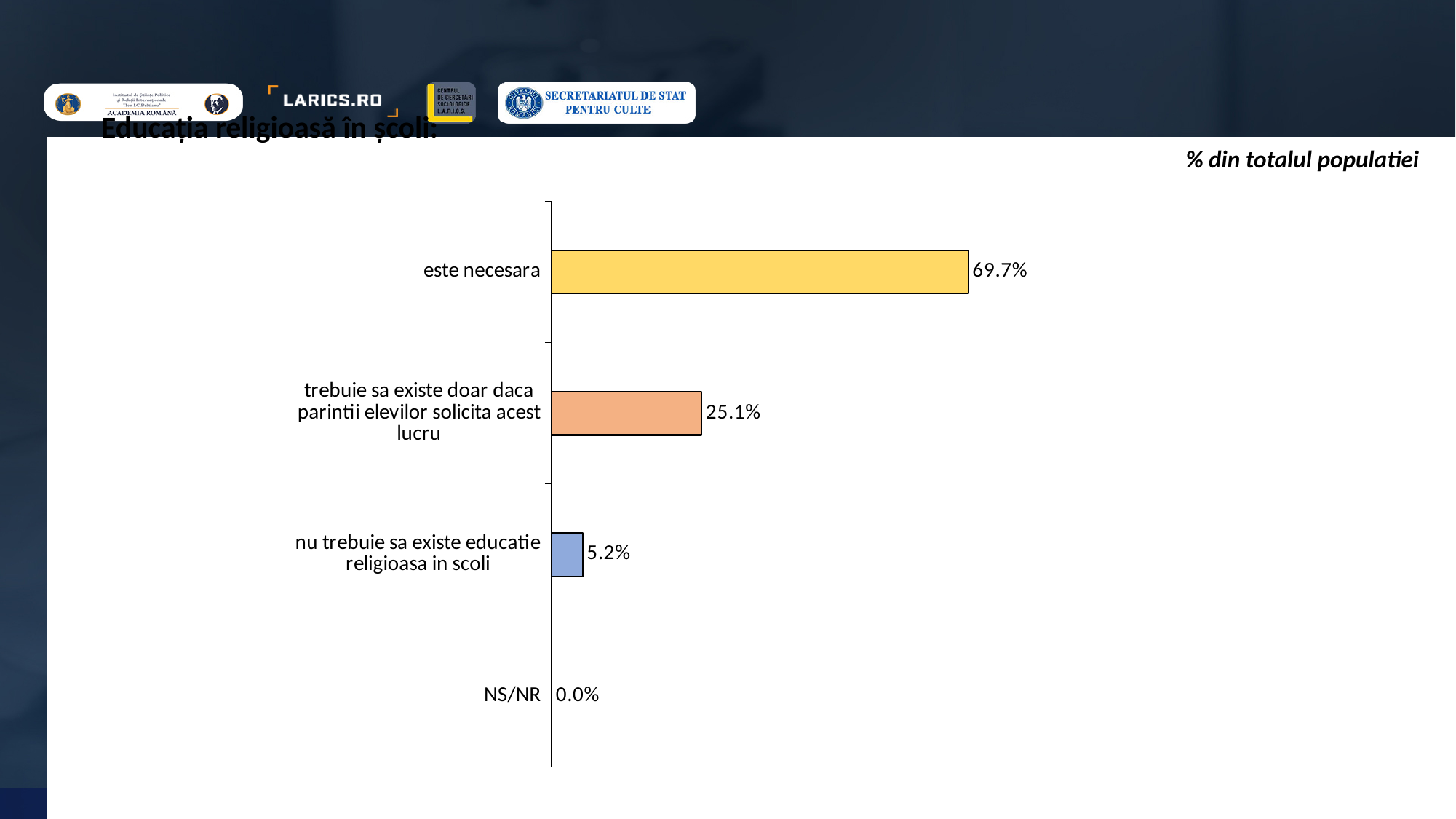
What unit note is shown at the top right of the chart? % din totalul populatiei What is the difference between the values for "este necesara" and "trebuie sa existe doar daca parintii elevilor solicita acest lucru"? 44.6% What kind of chart is shown on the slide? bar chart What is the value for "este necesara"? 69.7% What is the value for "NS/NR"? 0.0% Which category has the lowest value? NS/NR Which category has the highest value? este necesara Which is larger: the value for "nu trebuie sa existe educatie religioasa in scoli" or the value for "trebuie sa existe doar daca parintii elevilor solicita acest lucru"? trebuie sa existe doar daca parintii elevilor solicita acest lucru What is the difference between the values for "trebuie sa existe doar daca parintii elevilor solicita acest lucru" and "nu trebuie sa existe educatie religioasa in scoli"? 19.9% What is the value for "trebuie sa existe doar daca parintii elevilor solicita acest lucru"? 25.1% How many categories are shown in the chart? 4 What is the value for "nu trebuie sa existe educatie religioasa in scoli"? 5.2%